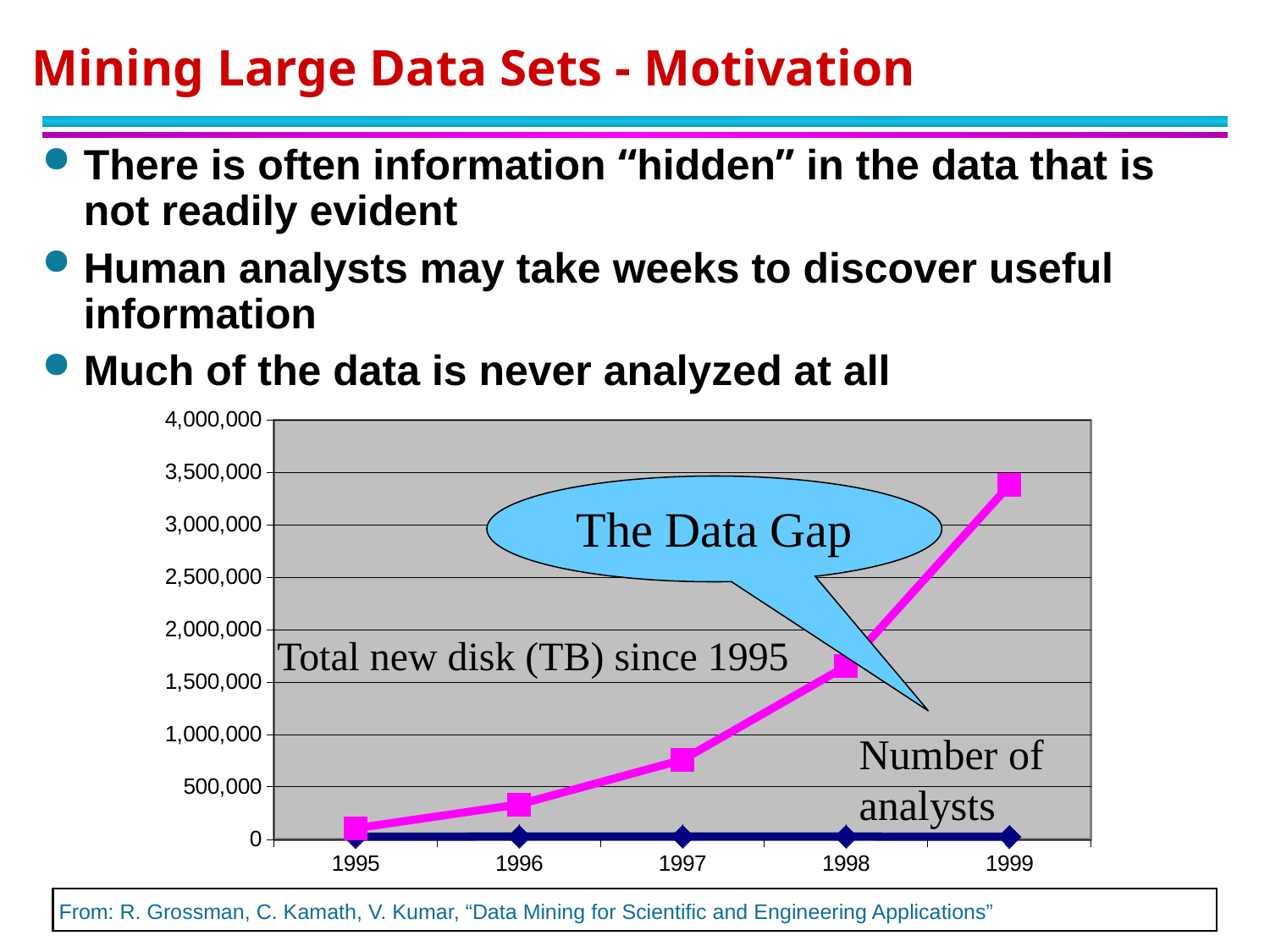
In 1999, which series has the larger value: 'Total new disk (TB) since 1995' or 'Number of analysts'? Total new disk (TB) since 1995 What text is written in the callout bubble on the chart? The Data Gap What kind of chart is shown on the slide? line chart Is the 'Total new disk (TB) since 1995' value for 1997 greater or less than 500,000? greater Is the 'Total new disk (TB) since 1995' value for 1999 greater or less than 3,000,000? greater Is the 'Total new disk (TB) since 1995' value for 1998 greater or less than 2,000,000? less Does the 'Total new disk (TB) since 1995' line rise or fall from 1995 to 1999? rise Which year is the first on the x axis of the chart? 1995 In which year is the 'Total new disk (TB) since 1995' value lowest? 1995 In which year is the 'Total new disk (TB) since 1995' value highest? 1999 How many years are shown along the x axis of the chart? 5